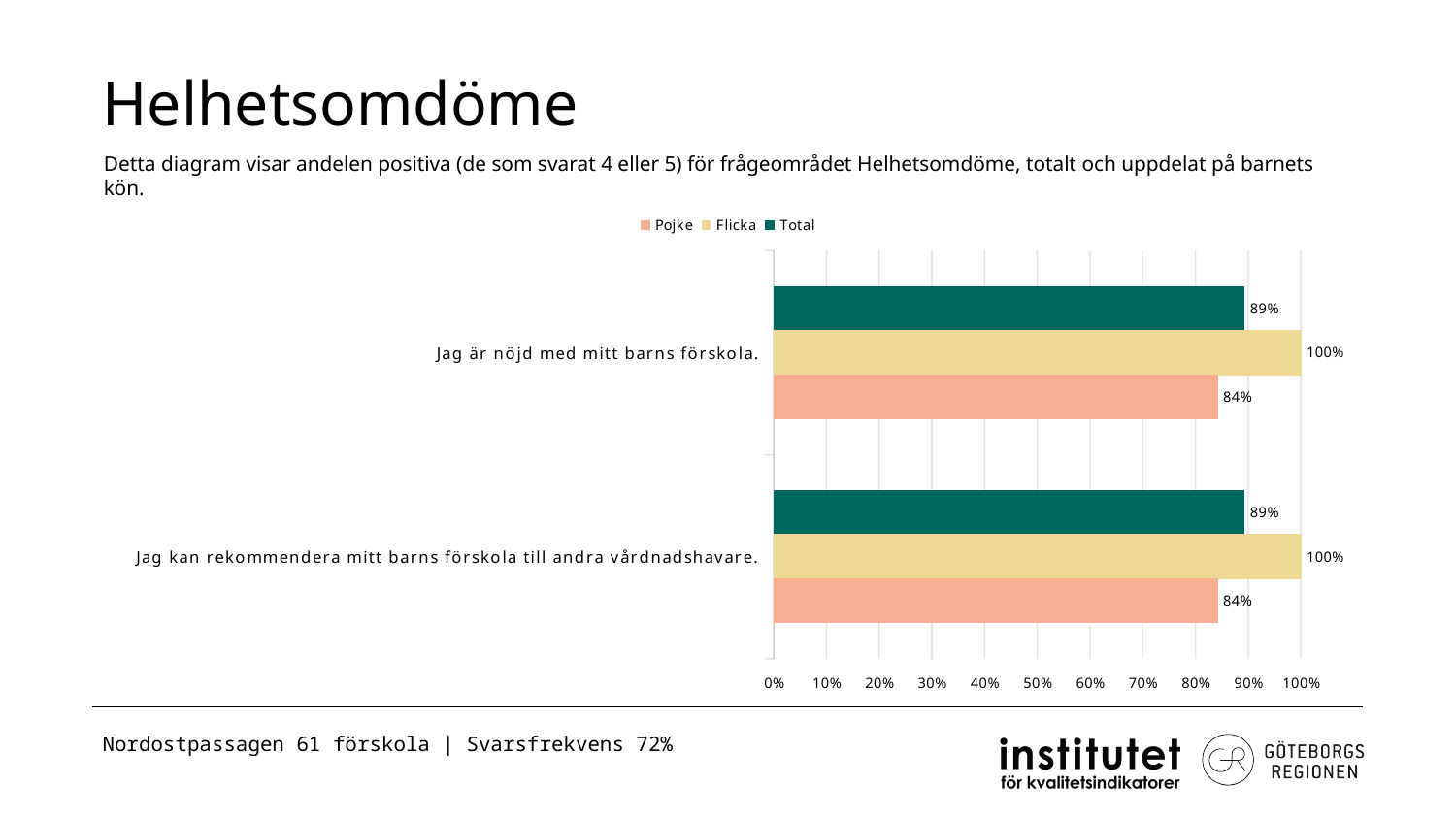
Which is larger for "Jag kan rekommendera mitt barns förskola till andra vårdnadshavare.": the Total value or the Pojke value? Total What is the Flicka value for "Jag är nöjd med mitt barns förskola."? 100% What is the Pojke value for "Jag kan rekommendera mitt barns förskola till andra vårdnadshavare."? 84% What kind of chart is shown on the slide? Bar chart Which series is shown in dark green in the legend? Total Which series has the lowest value for "Jag är nöjd med mitt barns förskola."? Pojke What is the difference between the Flicka and Pojke values for "Jag är nöjd med mitt barns förskola."? 16 percentage points How many question categories are shown on the chart? 2 What is the Total value for "Jag är nöjd med mitt barns förskola."? 89% Which series has the highest value for "Jag kan rekommendera mitt barns förskola till andra vårdnadshavare."? Flicka How many series does the legend list? 3 Is the Pojke value for "Jag är nöjd med mitt barns förskola." greater or less than 80%? greater